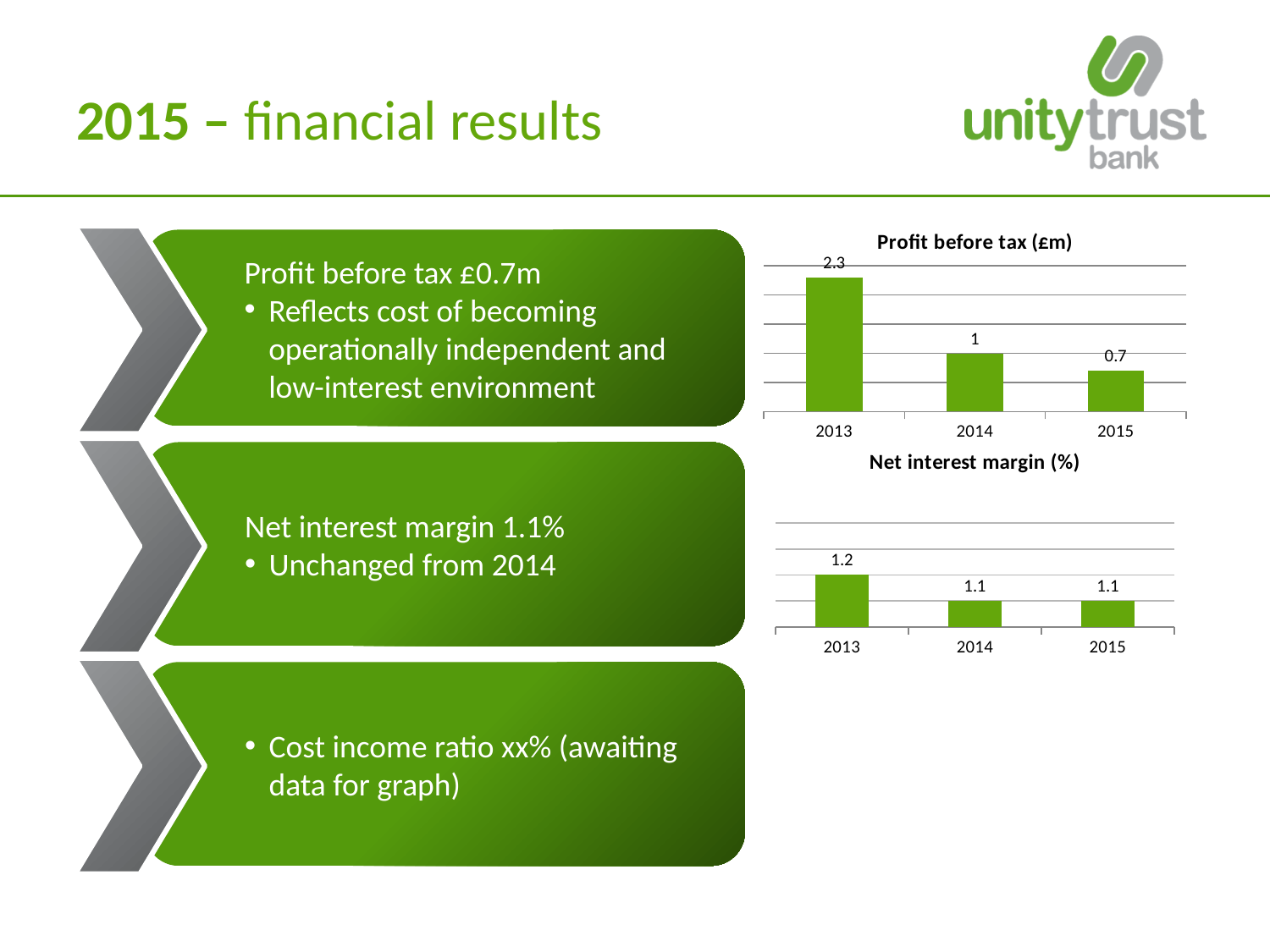
In the 'Net interest margin (%)' chart, what is the value for 2014? 1.1 In the 'Profit before tax (£m)' chart, what is the value for 2013? 2.3 In the 'Net interest margin (%)' chart, what is the difference between the 2013 and 2015 values? 0.1 In the 'Profit before tax (£m)' chart, which year has the lowest value? 2015 In the 'Profit before tax (£m)' chart, what is the difference between the 2013 and 2015 values? 1.6 In the 'Profit before tax (£m)' chart, what is the value for 2015? 0.7 In the 'Profit before tax (£m)' chart, which year has the highest value? 2013 What kind of chart is the 'Net interest margin (%)' chart? bar chart In the 'Profit before tax (£m)' chart, how many years are shown? 3 In the 'Net interest margin (%)' chart, what is the value for 2013? 1.2 In the 'Net interest margin (%)' chart, which year has the highest value? 2013 In the 'Profit before tax (£m)' chart, do the values rise or fall from 2013 to 2015? fall